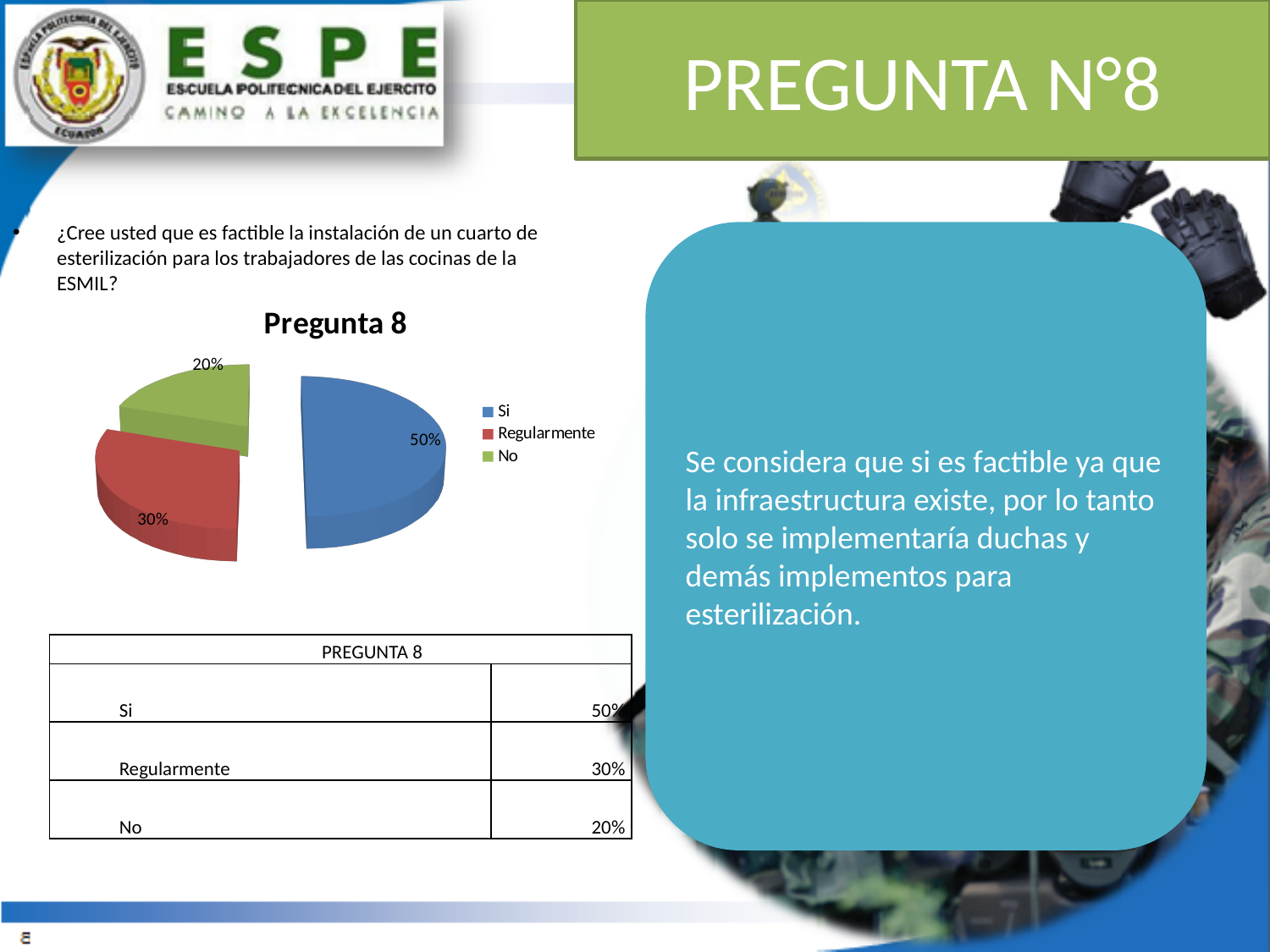
What is the difference in percentage points between the "Si" and "No" slices? 30% What share of the pie does the "No" slice represent? 20% Which is larger, the "Regularmente" slice or the "No" slice? Regularmente What share of the pie does the "Si" slice represent? 50% Which category has the smallest slice of the pie? No What kind of chart is shown on the slide? Pie chart What is the difference in percentage points between the "Regularmente" and "No" slices? 10% What colour is the "Si" slice in the pie chart? Blue What share of the pie does the "Regularmente" slice represent? 30% How many categories does the pie chart have? 3 What is the title of the chart? Pregunta 8 Which category has the largest slice of the pie? Si